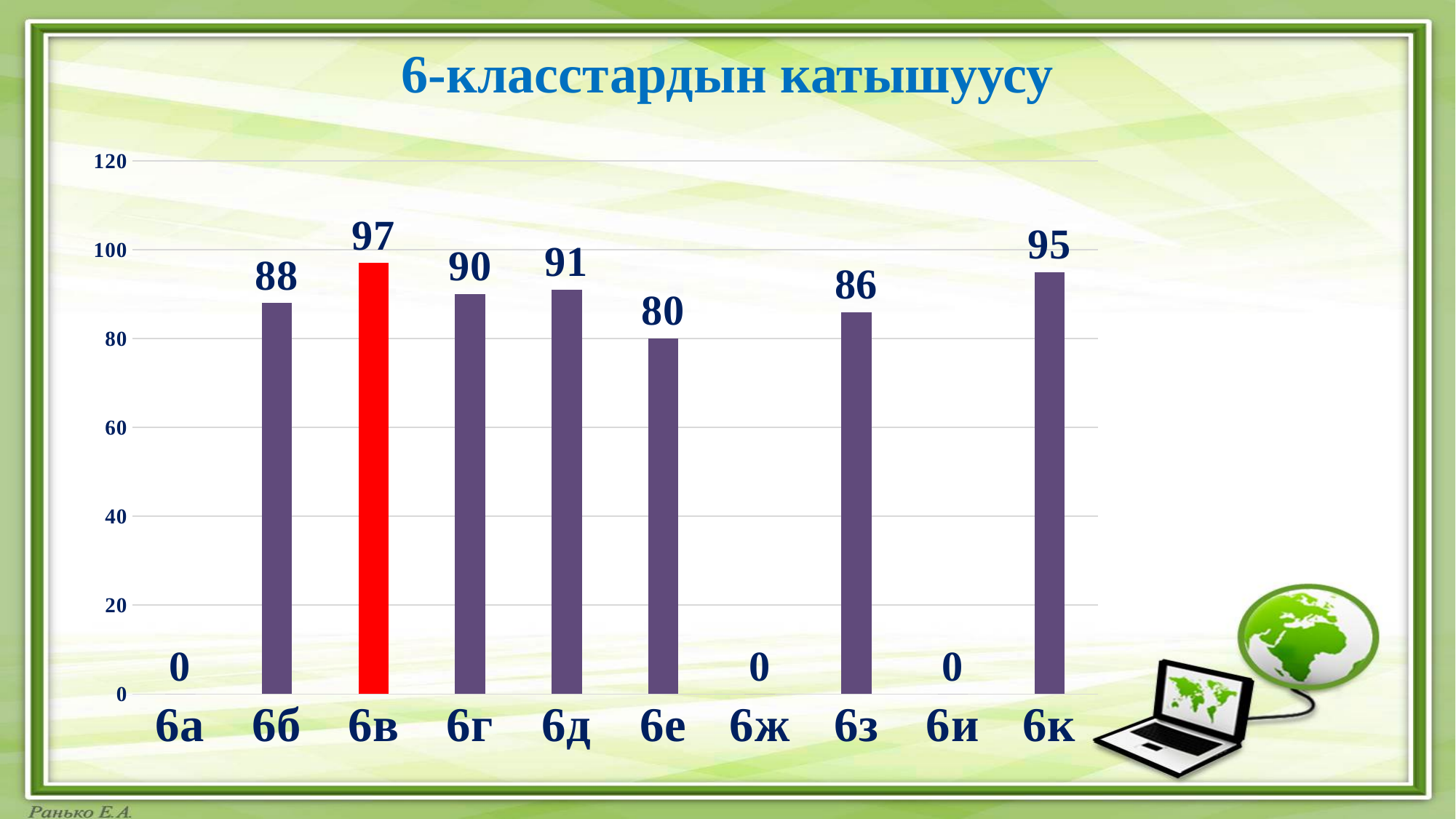
What is the value for 6е? 80 What kind of chart is shown on the slide? bar chart What is the difference between the values for 6к and 6б? 7 Which category has the highest value? 6в What is the value for 6в? 97 How many categories have a value of 0? 3 Which bar is coloured red? 6в What is the difference between the values for 6в and 6е? 17 How many categories are shown on the x axis? 10 Which is larger, the value for 6г or the value for 6д? 6д What is the value for 6з? 86 Which category has the highest non-zero value after 6в? 6к